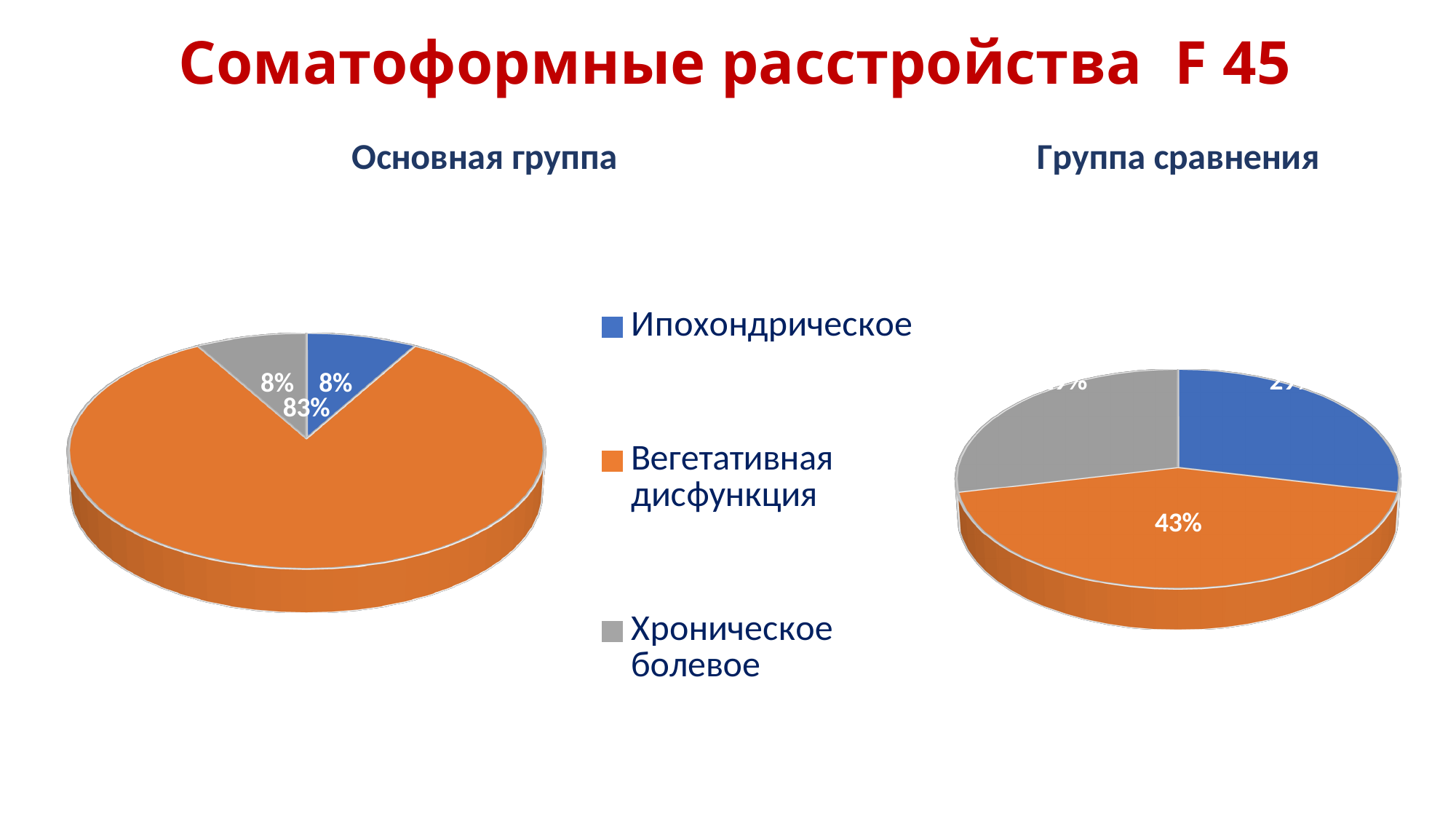
How many categories does the legend list? 3 In the "Основная группа" chart, what is the value for Вегетативная дисфункция? 83% In the "Группа сравнения" chart, which category has the largest slice? Вегетативная дисфункция In the "Основная группа" chart, what is the difference between the values for Вегетативная дисфункция and Ипохондрическое? 75 percentage points In the "Основная группа" chart, which category has the largest slice? Вегетативная дисфункция How many slices does the "Основная группа" pie chart have? 3 In the "Основная группа" chart, what is the value for Ипохондрическое? 8% What kind of chart is the "Основная группа" chart? Pie chart In the "Группа сравнения" chart, what is the value for Вегетативная дисфункция? 43% Is the value for Вегетативная дисфункция larger in the "Основная группа" chart or in the "Группа сравнения" chart? Основная группа In the "Основная группа" chart, what is the value for Хроническое болевое? 8% What colour represents Ипохондрическое in the legend? Blue